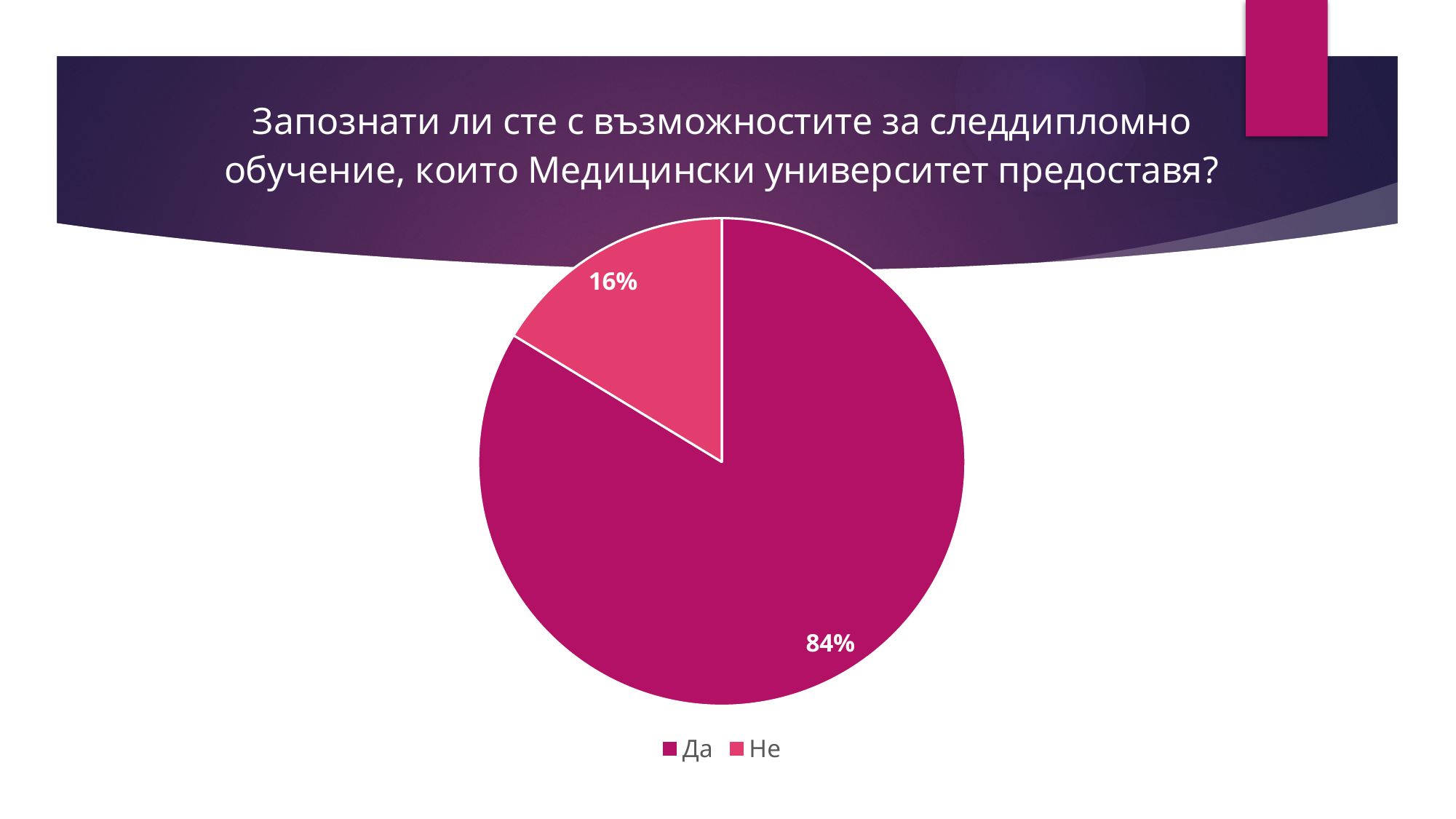
What share of the pie does "Да" represent? 84% Which is larger, the "Да" slice or the "Не" slice? Да What is the difference in percentage points between the "Да" and "Не" slices? 68 How many entries does the legend list? 2 Which slice of the pie is the smallest? Не Which slice of the pie is the largest? Да What is the title of the chart? Запознати ли сте с възможностите за следдипломно обучение, които Медицински университет предоставя? What kind of chart is shown on the slide? pie chart What share of the pie does "Не" represent? 16% How many slices does the pie chart have? 2 Which legend entry is shown in the lighter pink colour? Не